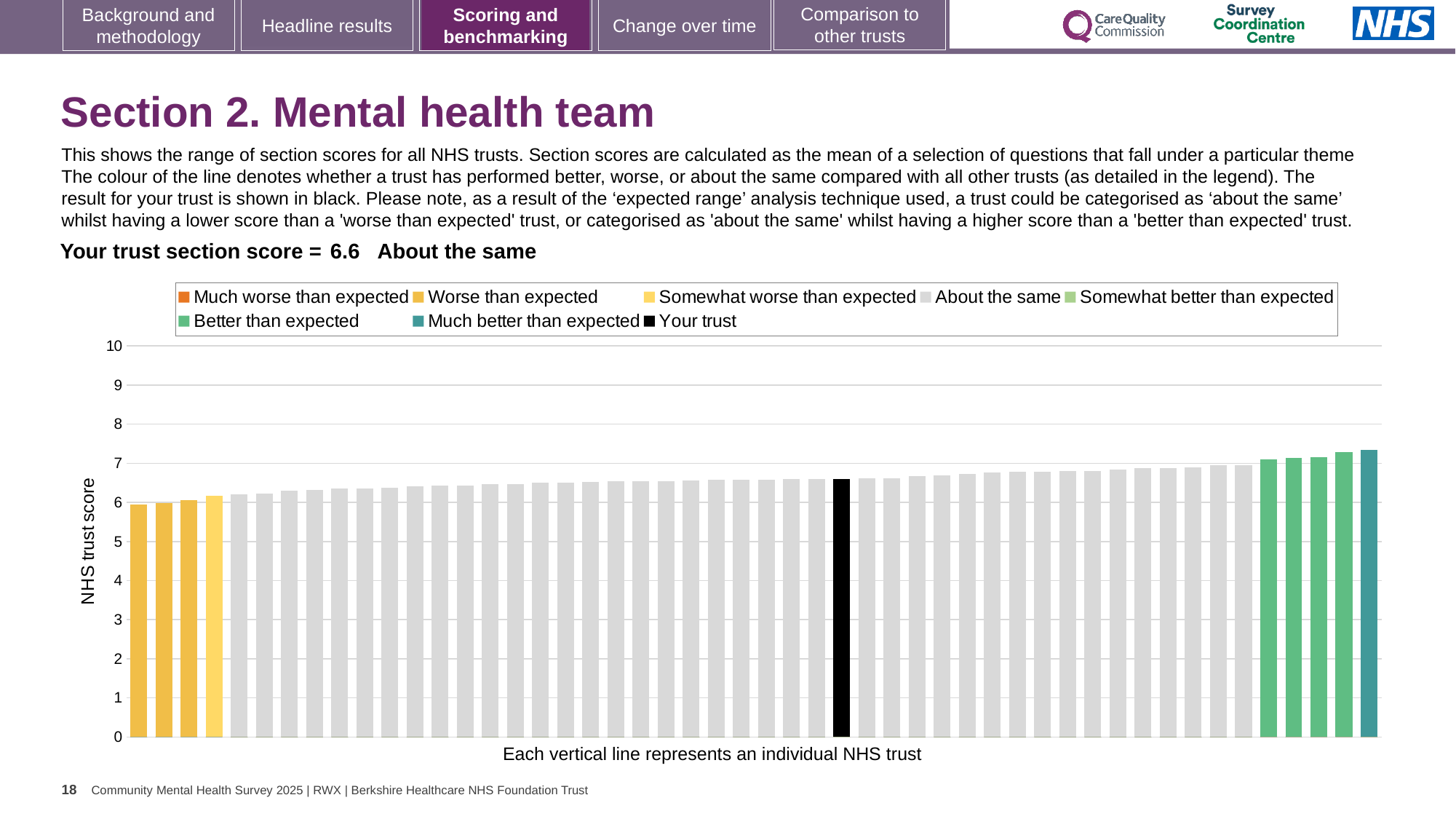
Is the value for your trust greater or less than 6? greater Is the value of the highest bar (rightmost trust) greater or less than 7? greater What kind of chart is shown on the slide? bar chart What is the section score for your trust shown on the slide? 6.6 How is your trust's section score categorised compared with other trusts? About the same Which is larger: the value for your trust or the value of the rightmost bar? the rightmost bar What colour is the bar representing your trust? black Do the bar values rise or fall from left to right along the x axis? rise Is the value for your trust greater or less than 7? less What is the label on the vertical axis of the chart? NHS trust score How many entries does the chart legend list? 8